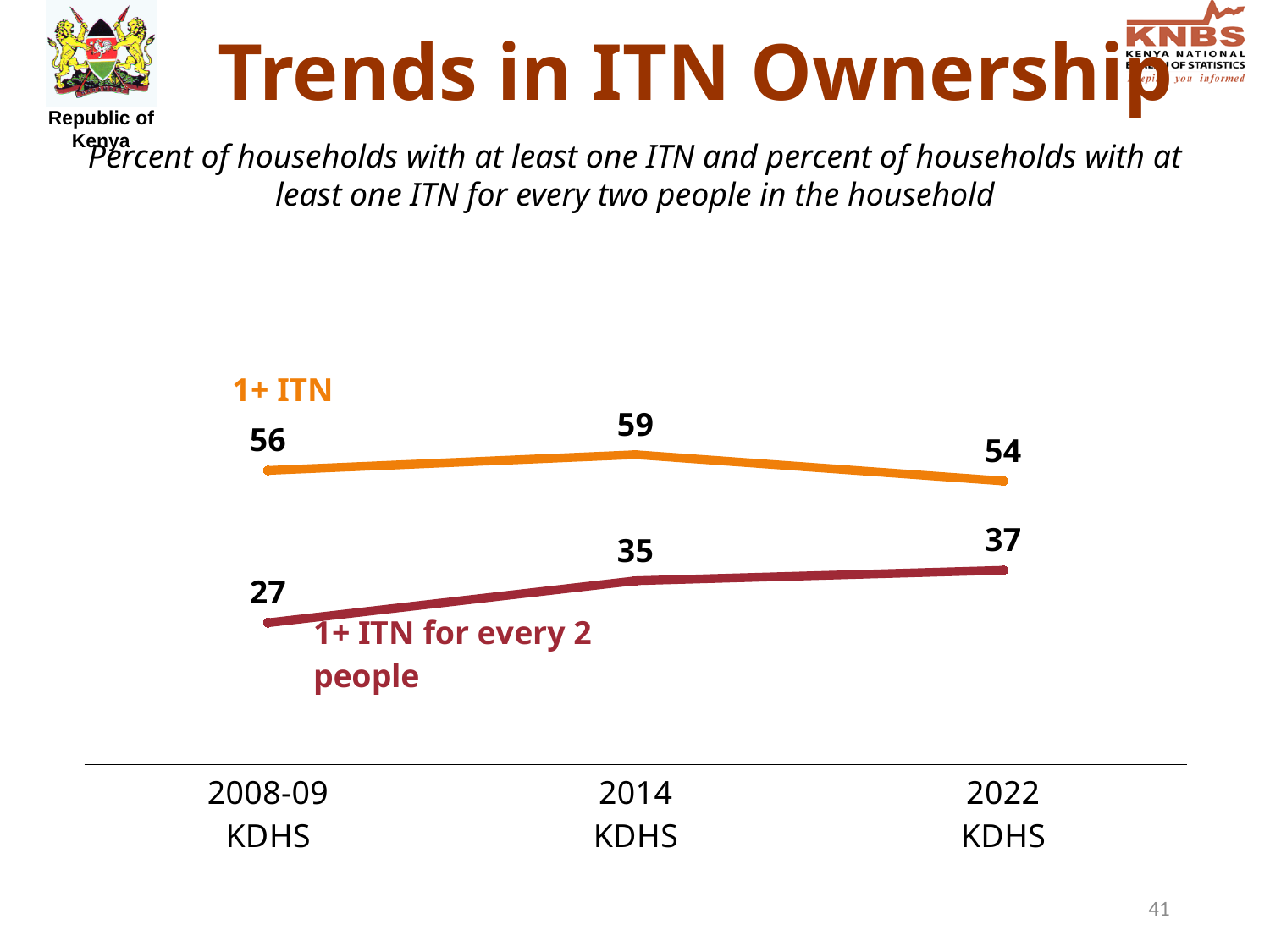
What is the difference between the 1+ ITN value and the 1+ ITN for every 2 people value in the 2008-09 KDHS? 29 How many survey years are shown on the x axis? 3 What is the value for 1+ ITN for every 2 people in the 2022 KDHS? 37 Does the 1+ ITN for every 2 people line rise or fall from the 2008-09 KDHS to the 2022 KDHS? Rise What is the value for 1+ ITN for every 2 people in the 2008-09 KDHS? 27 What is the value for 1+ ITN in the 2022 KDHS? 54 Which is larger in the 2014 KDHS: the 1+ ITN value or the 1+ ITN for every 2 people value? 1+ ITN What is the value for 1+ ITN in the 2014 KDHS? 59 In which survey is the 1+ ITN value highest? 2014 KDHS What kind of chart is shown on the slide? Line chart By how much did the 1+ ITN for every 2 people value change from the 2008-09 KDHS to the 2022 KDHS? 10 In which survey is the 1+ ITN for every 2 people value lowest? 2008-09 KDHS